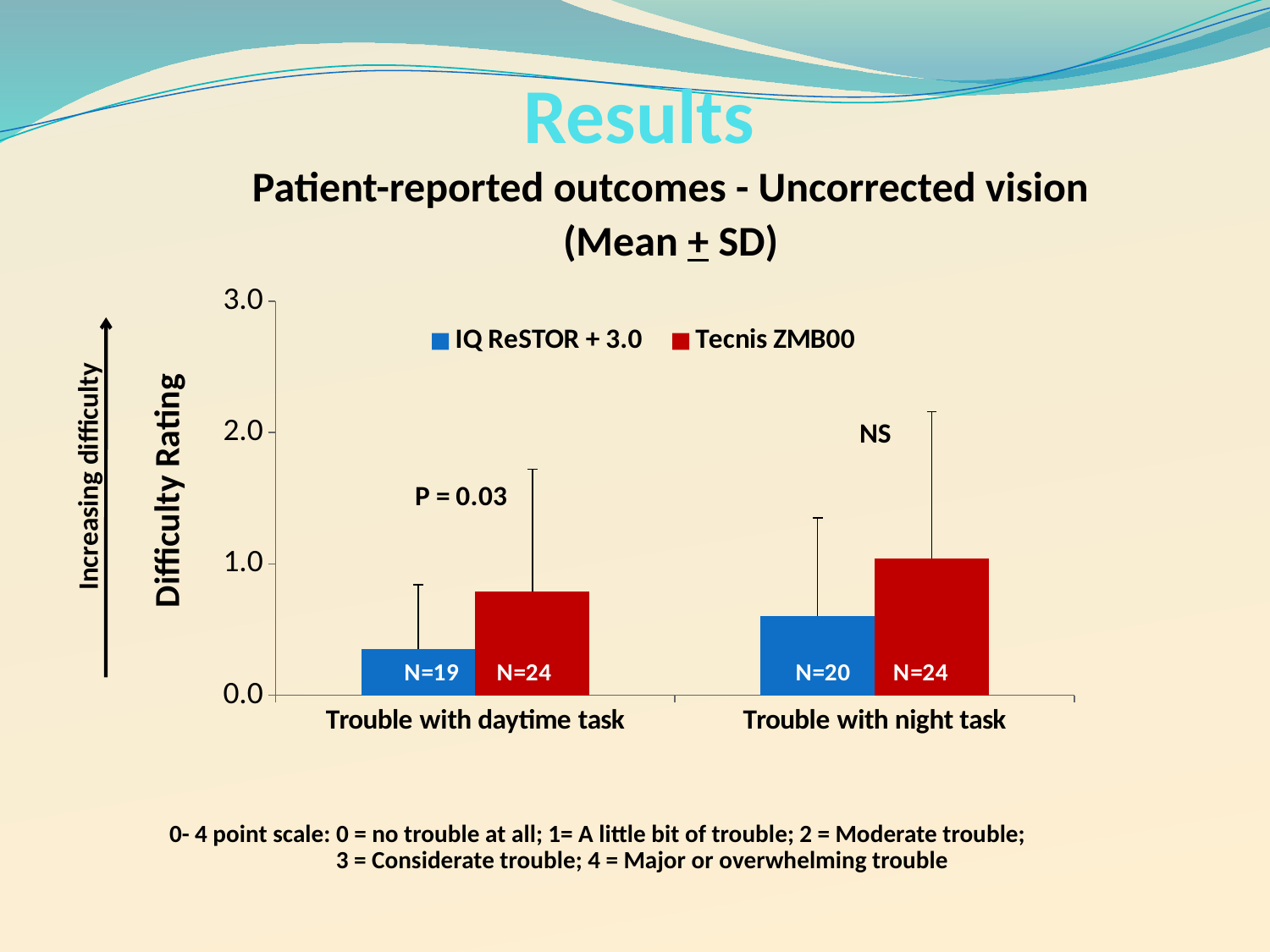
How many series does the legend list? 2 Which series is shown in red in the legend? Tecnis ZMB00 How many categories are shown on the x axis? 2 What kind of chart is shown on the slide? bar chart Is the difficulty rating for IQ ReSTOR + 3.0 on Trouble with daytime task greater or less than 1.0? less What is the N label on the Tecnis ZMB00 bar for Trouble with night task? N=24 Which bar has the lowest difficulty rating in the chart? IQ ReSTOR + 3.0, Trouble with daytime task What is the N label on the IQ ReSTOR + 3.0 bar for Trouble with night task? N=20 For Trouble with night task, which series has the larger difficulty rating, IQ ReSTOR + 3.0 or Tecnis ZMB00? Tecnis ZMB00 What P value is annotated above the Trouble with daytime task bars? P = 0.03 What is the N label on the IQ ReSTOR + 3.0 bar for Trouble with daytime task? N=19 For Trouble with daytime task, which series has the larger difficulty rating, IQ ReSTOR + 3.0 or Tecnis ZMB00? Tecnis ZMB00